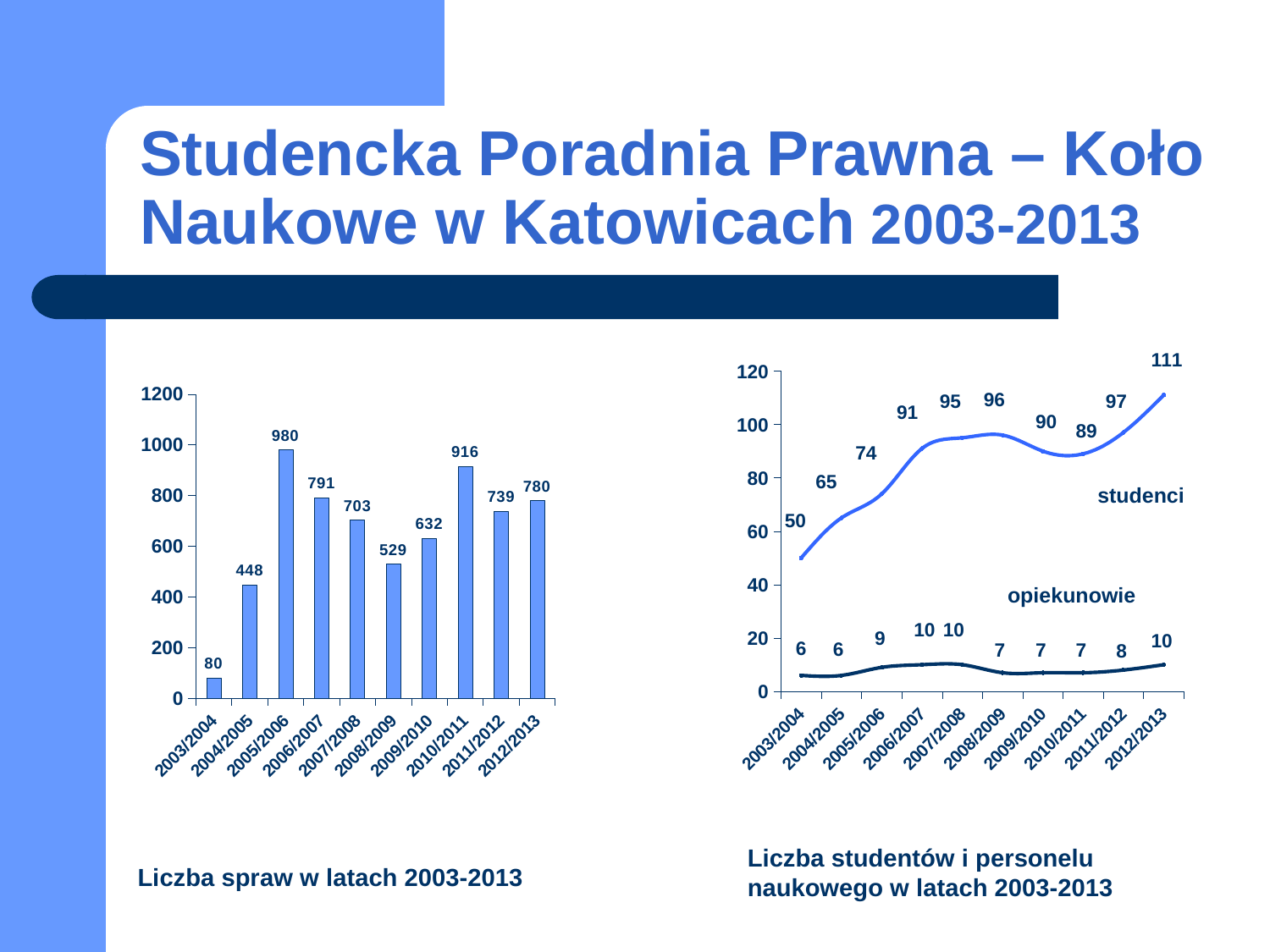
In the left chart (Liczba spraw w latach 2003-2013), how many years are shown on the x axis? 10 In the left chart (Liczba spraw w latach 2003-2013), which is larger, the value for 2006/2007 or 2012/2013? 2006/2007 In the right chart (Liczba studentów i personelu naukowego), what is the difference between studenci and opiekunowie in 2003/2004? 44 In the left chart (Liczba spraw w latach 2003-2013), what is the difference between the values for 2010/2011 and 2011/2012? 177 In the right chart (Liczba studentów i personelu naukowego), what is the value for studenci in 2012/2013? 111 In the right chart (Liczba studentów i personelu naukowego), what is the value for opiekunowie in 2005/2006? 9 What kind of chart is the right chart (Liczba studentów i personelu naukowego)? line chart In the left chart (Liczba spraw w latach 2003-2013), which year has the lowest value? 2003/2004 What kind of chart is the left chart (Liczba spraw w latach 2003-2013)? bar chart In the left chart (Liczba spraw w latach 2003-2013), what is the value for 2005/2006? 980 In the right chart (Liczba studentów i personelu naukowego), how many series are plotted? 2 In the left chart (Liczba spraw w latach 2003-2013), which year has the highest value? 2005/2006